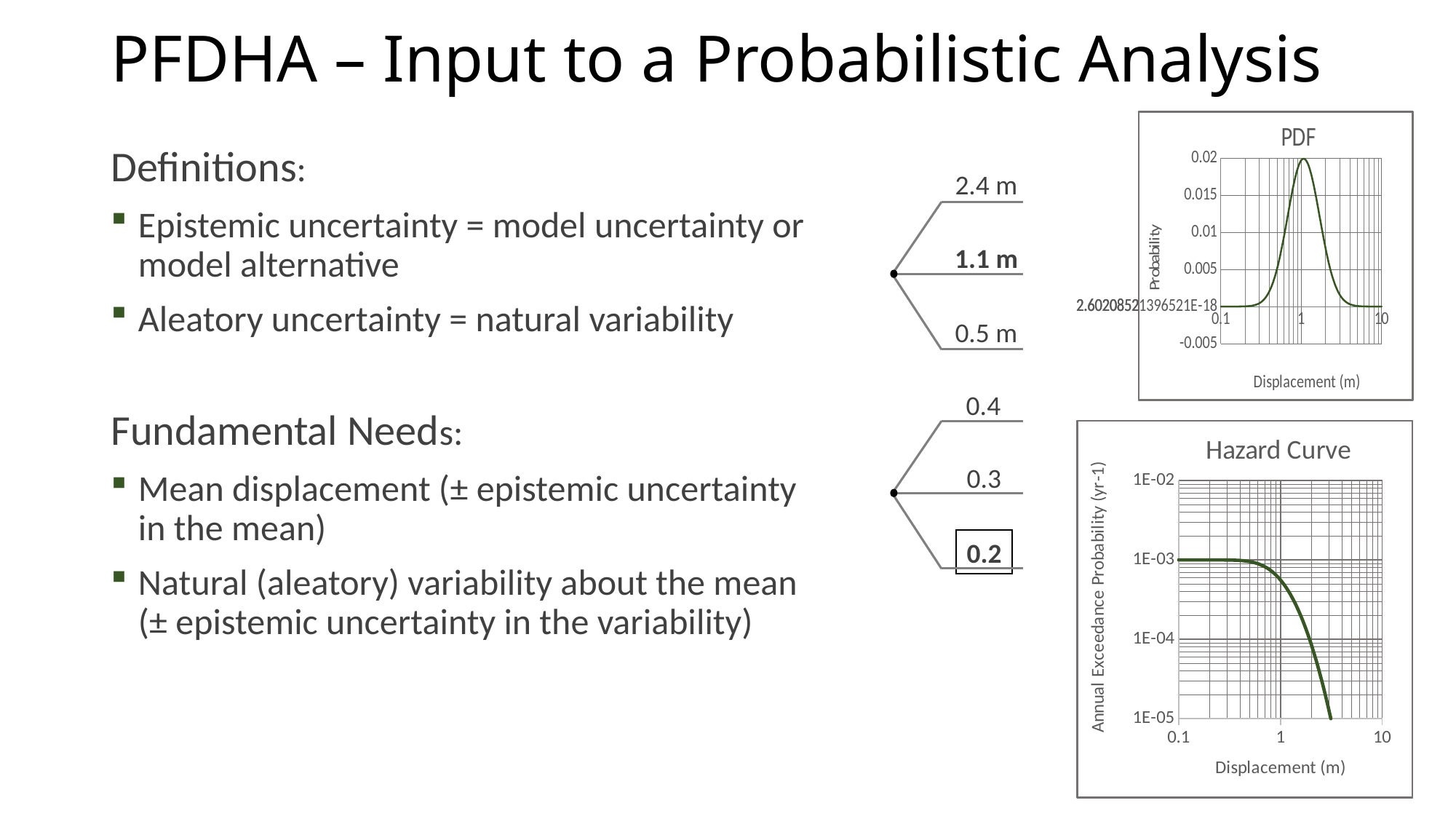
In the PDF chart, is the probability at a displacement of 0.1 m greater or less than 0.005? less What is the x-axis label of the PDF chart? Displacement (m) What kind of chart is the Hazard Curve chart? line chart What is the y-axis label of the Hazard Curve chart? Annual Exceedance Probability (yr-1) In the PDF chart, is the probability at a displacement of 10 m greater or less than 0.005? less In the Hazard Curve chart, does the annual exceedance probability rise or fall as displacement increases from 1 to 10 m? fall What kind of chart is the PDF chart? line chart How many charts are shown on the slide? 2 In the PDF chart, does the probability rise or fall as displacement increases from 1 m to 10 m? fall In the Hazard Curve chart, is the annual exceedance probability at a displacement of 0.1 m greater or less than 1E-02? less